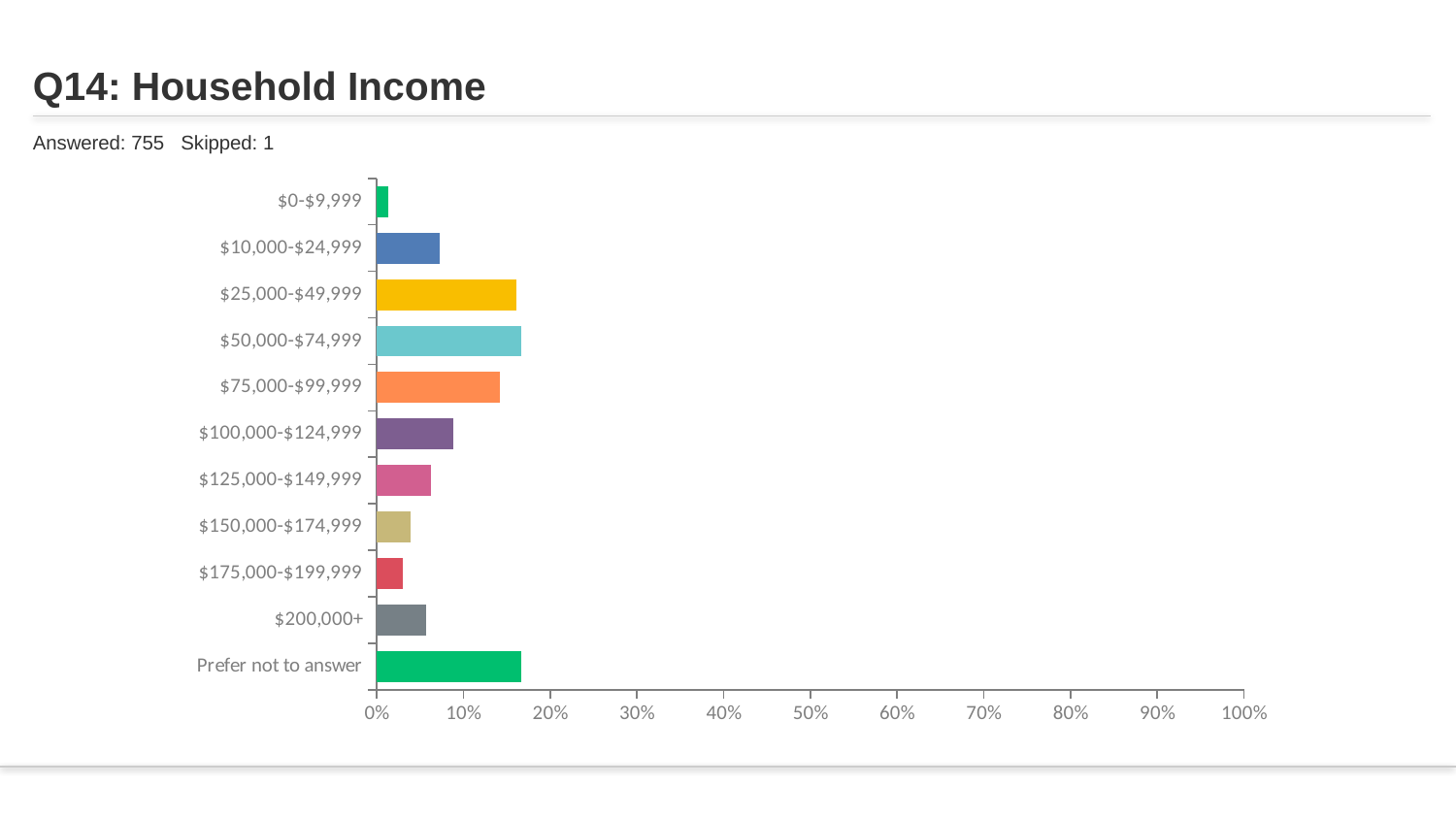
What is the title of the chart on the slide? Q14: Household Income How many respondents answered the question shown in the chart? 755 Which is larger, the value for $10,000-$24,999 or the value for $150,000-$174,999? $10,000-$24,999 Which income category has the lowest percentage? $0-$9,999 What kind of chart is shown on the slide? bar chart Is the value for $125,000-$149,999 greater or less than 10%? less Is the value for $10,000-$24,999 greater or less than 10%? less Is the value for $25,000-$49,999 greater or less than 10%? greater Which is larger, the value for $75,000-$99,999 or the value for $100,000-$124,999? $75,000-$99,999 How many income categories are plotted in the chart? 11 Which is larger, the value for $200,000+ or the value for $175,000-$199,999? $200,000+